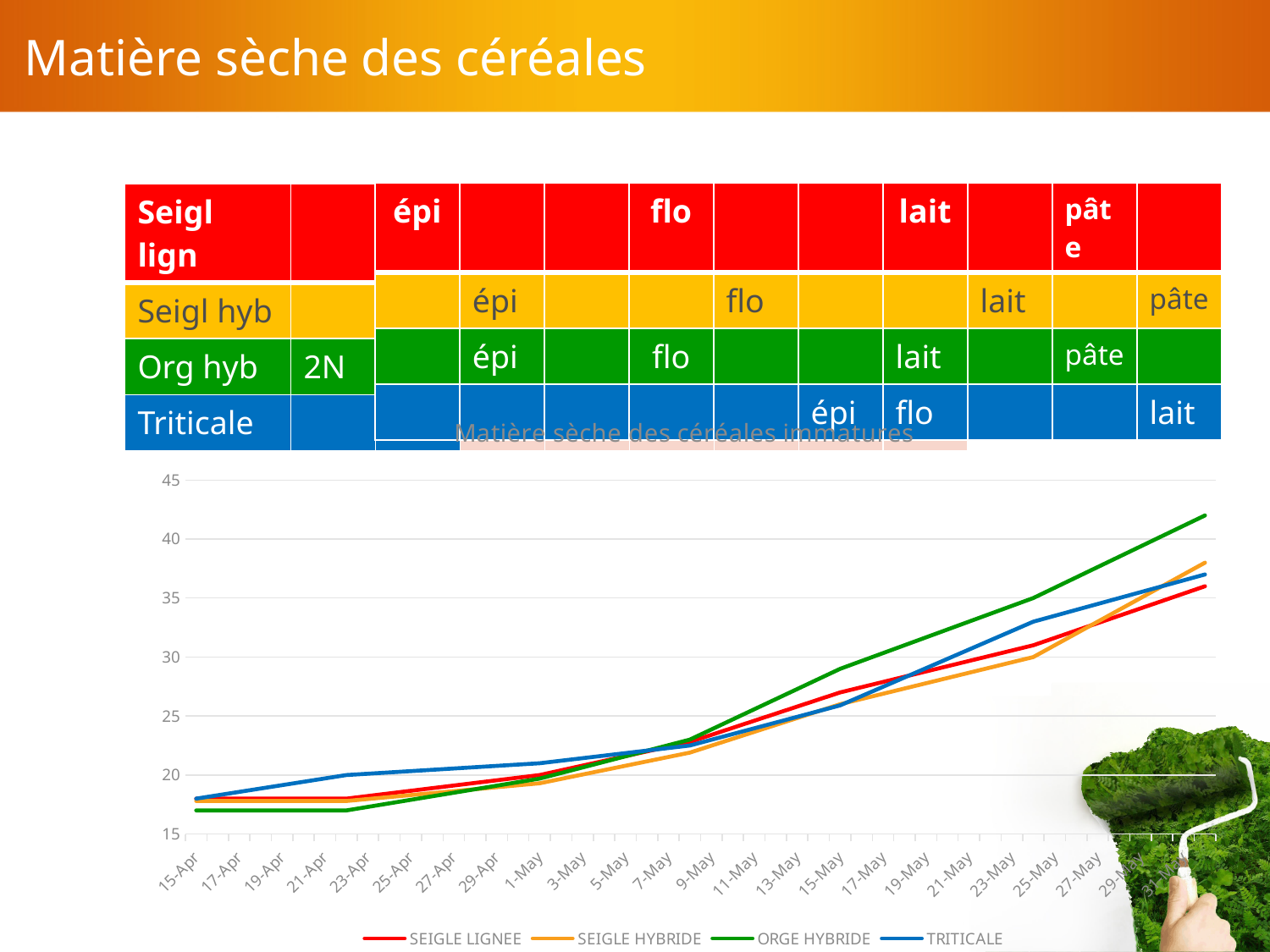
Is the value for ORGE HYBRIDE at 31-May greater or less than 40? greater How many series does the chart legend list? 4 Is the value for ORGE HYBRIDE at 21-May greater or less than 30? greater Do the values for the series rise or fall from 15-Apr to 31-May? rise Which series is lowest at 15-Apr? ORGE HYBRIDE What kind of chart is shown on the slide? line chart Is the value for TRITICALE at 15-Apr greater or less than 20? less At 23-Apr, which is larger: TRITICALE or ORGE HYBRIDE? TRITICALE Which series is highest at 31-May? ORGE HYBRIDE What is the title of the chart? Matière sèche des céréales immatures At 31-May, which is larger: ORGE HYBRIDE or SEIGLE LIGNEE? ORGE HYBRIDE